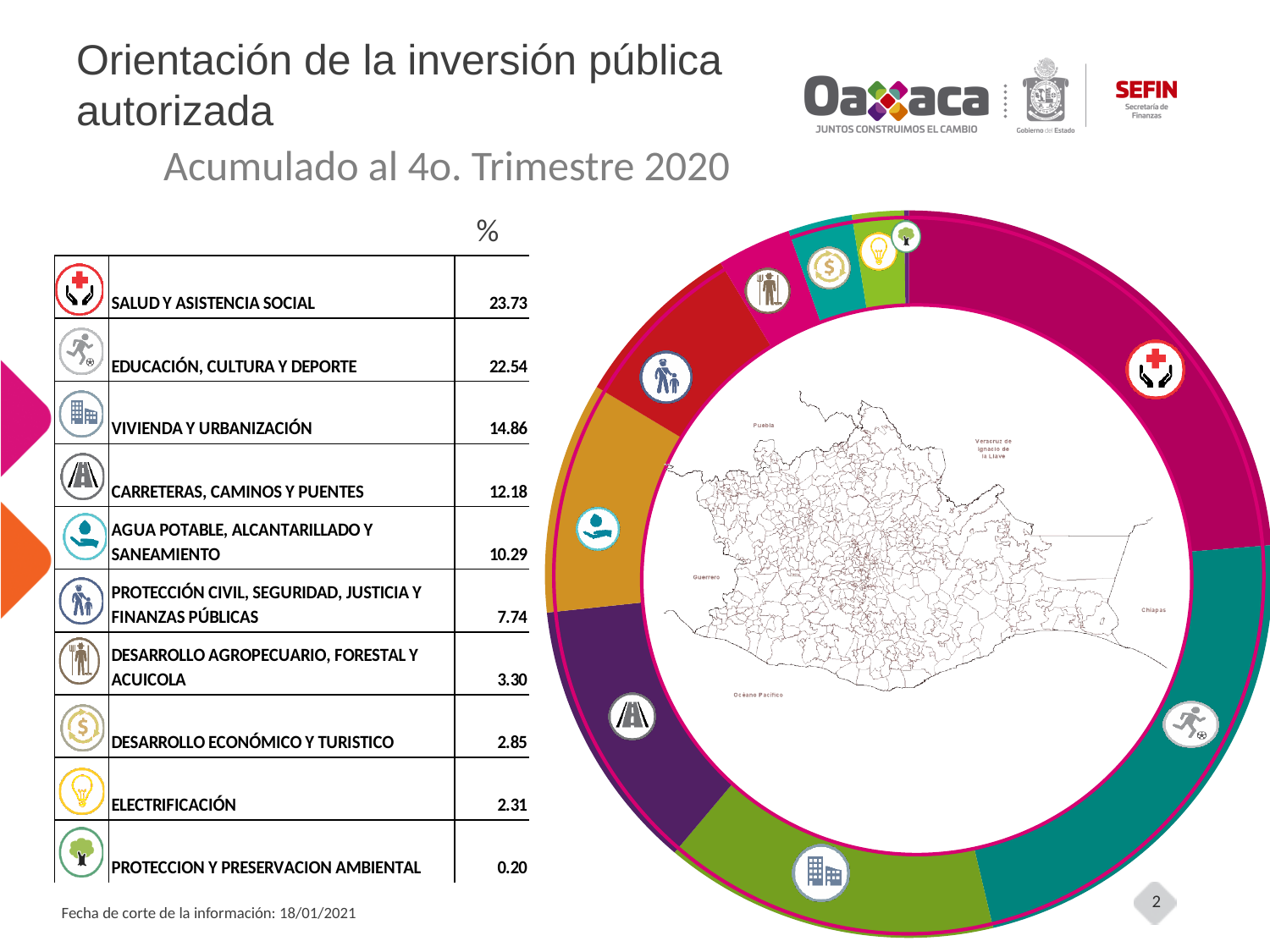
Which is larger, the share for Desarrollo Económico y Turístico or the share for Electrificación? Desarrollo Económico y Turístico What percentage is shown for Carreteras, Caminos y Puentes? 12.18 What is the cut-off date of the information shown on the slide? 18/01/2021 Which category has the smallest share of authorized public investment? Protección y Preservación Ambiental What percentage of authorized public investment goes to Salud y Asistencia Social? 23.73 What is the difference in percentage points between Vivienda y Urbanización and Carreteras, Caminos y Puentes? 2.68 Which category has the largest share of authorized public investment? Salud y Asistencia Social How many categories are listed in the table of authorized public investment? 10 What percentage is shown for Electrificación? 2.31 What kind of chart is shown on the right of the slide? donut chart What percentage is shown for Educación, Cultura y Deporte? 22.54 What is the combined percentage of Salud y Asistencia Social and Educación, Cultura y Deporte? 46.27